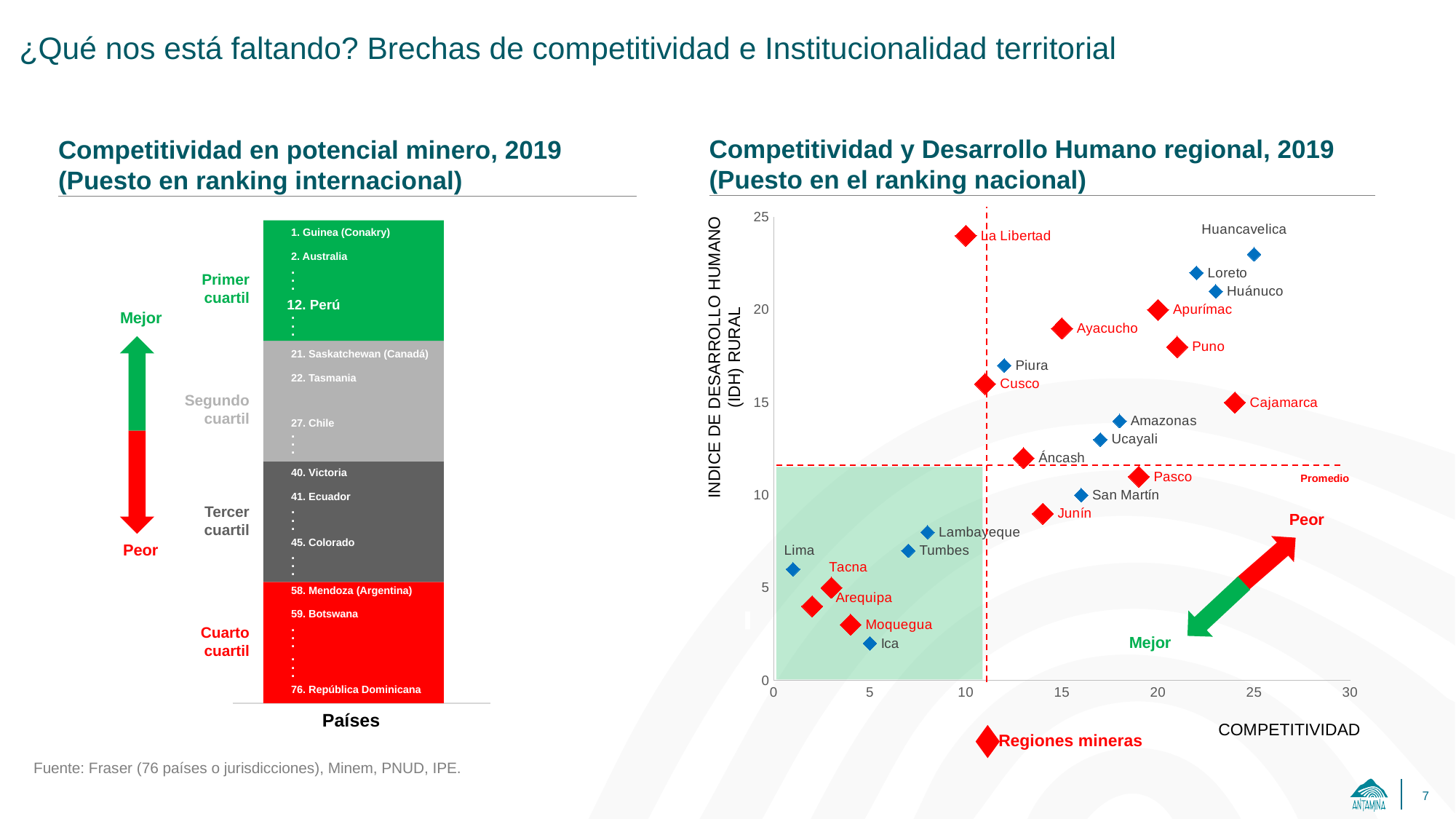
In the chart 'Competitividad y Desarrollo Humano regional, 2019', which has a higher IDH rural value, Cajamarca or Ica? Cajamarca In the chart 'Competitividad y Desarrollo Humano regional, 2019', which region has the lowest competitividad value? Lima In the chart 'Competitividad en potencial minero, 2019', which country is ranked 76? República Dominicana In the chart 'Competitividad en potencial minero, 2019', which jurisdiction is ranked first? Guinea (Conakry) In the chart 'Competitividad en potencial minero, 2019', how many quartiles are shown in the bar? 4 In the chart 'Competitividad en potencial minero, 2019', what is the difference in ranking position between Chile (27) and Perú (12)? 15 In the chart 'Competitividad y Desarrollo Humano regional, 2019', is the competitividad value for Lima greater or less than 5? less In the chart 'Competitividad en potencial minero, 2019', what ranking position does Perú hold? 12 In the chart 'Competitividad en potencial minero, 2019', which quartile is Chile placed in? Segundo cuartil In the chart 'Competitividad y Desarrollo Humano regional, 2019', how many regions are marked as 'Regiones mineras' (red diamonds)? 12 In the chart 'Competitividad y Desarrollo Humano regional, 2019', is the IDH rural value for La Libertad greater or less than 20? greater What kind of chart is 'Competitividad y Desarrollo Humano regional, 2019'? Scatter chart